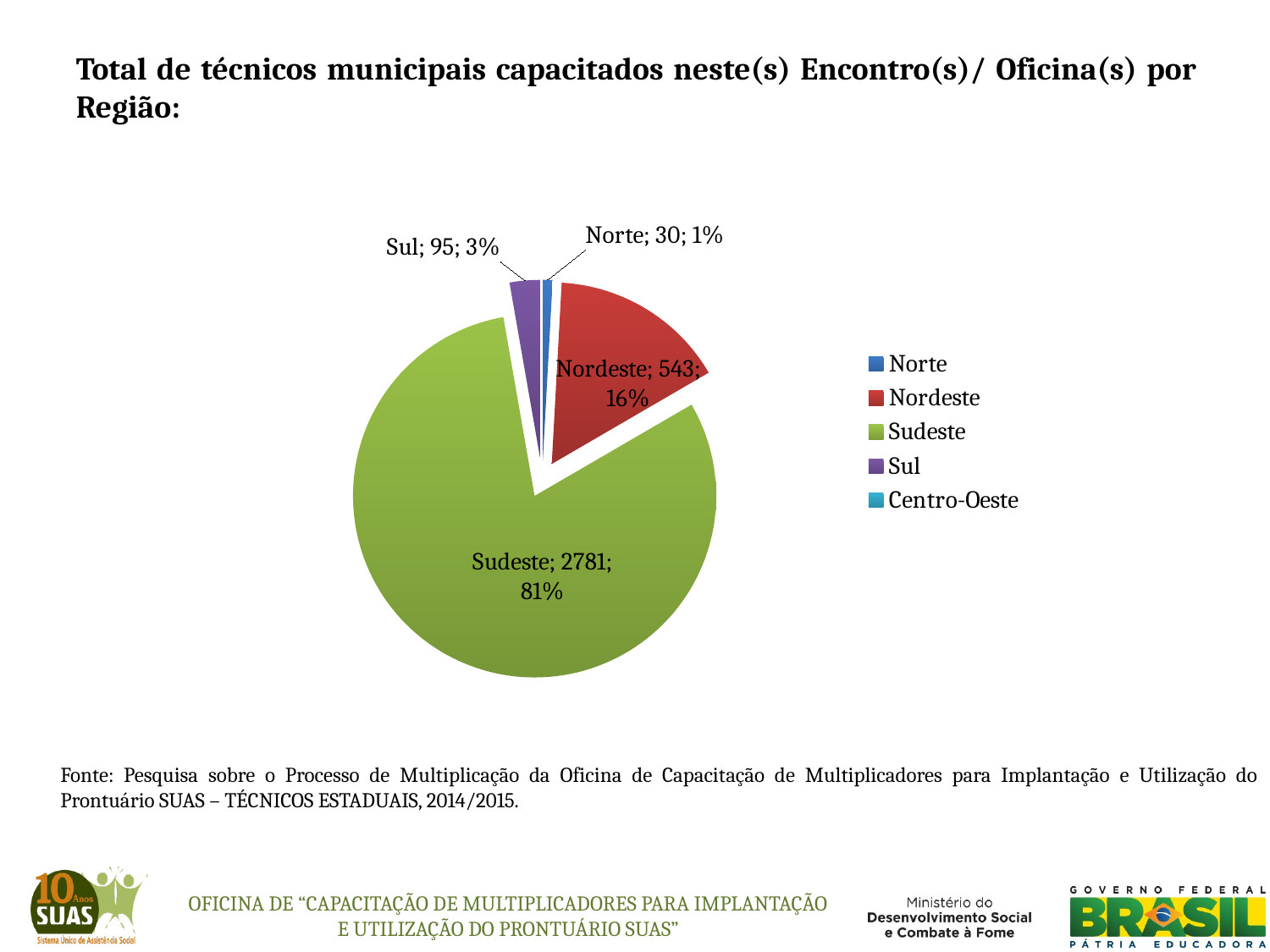
How many technicians were trained in the Nordeste region? 543 Which region has a larger value, Sul or Norte? Sul Which labelled region has the smallest slice of the pie? Norte What percentage share of the pie does Sudeste represent? 81% What is the difference between the values for Sudeste and Nordeste? 2238 What value is shown for the Norte region? 30 What value is shown for the Sul region? 95 How many entries does the legend list? 5 How many technicians were trained in the Sudeste region? 2781 What percentage share of the pie does Nordeste represent? 16% Which region has the largest slice of the pie? Sudeste What type of chart is shown on the slide? pie chart